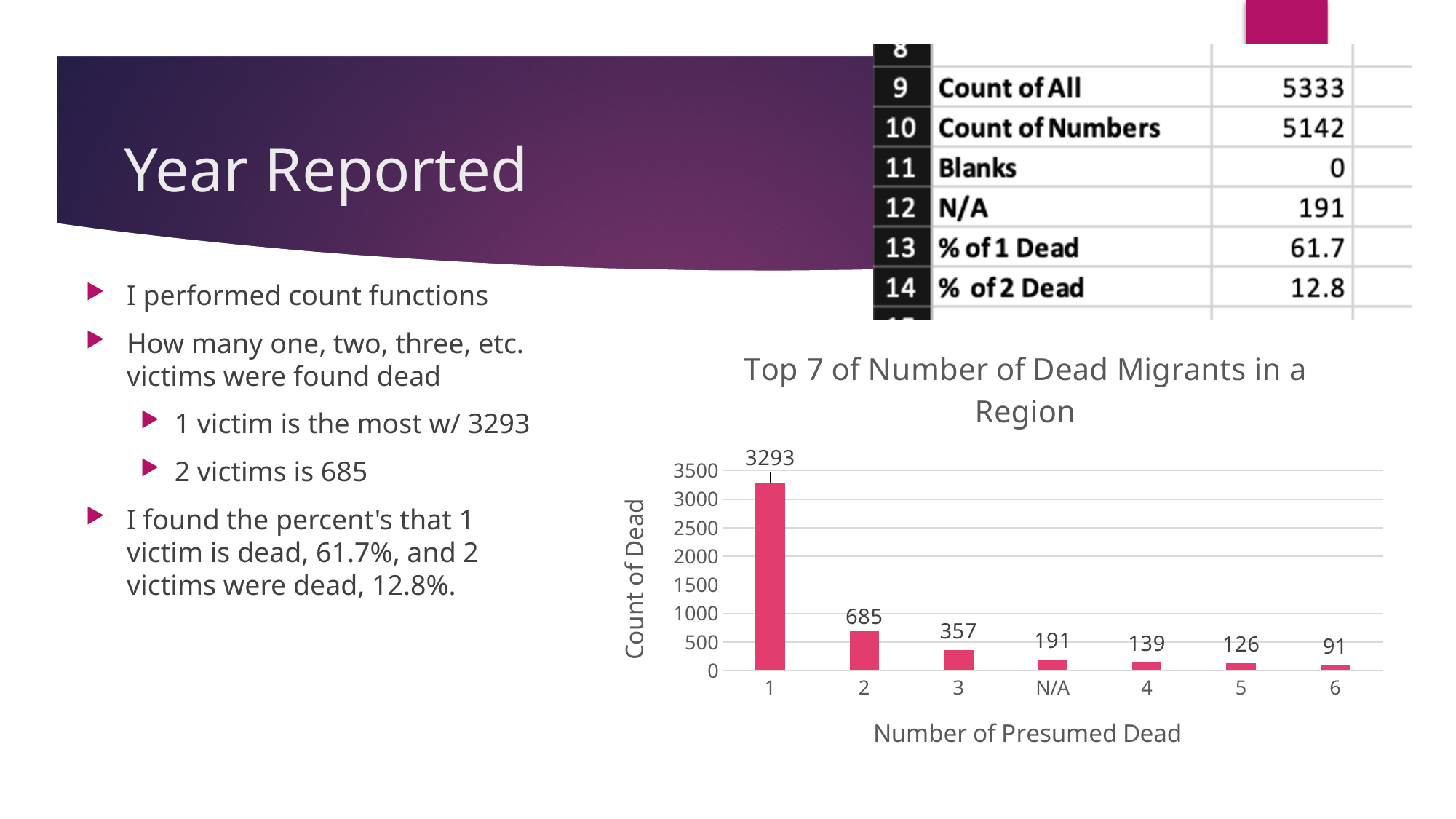
Which is larger, the count for 4 presumed dead or for 5 presumed dead? 4 What is the count of dead for 6 presumed dead? 91 Which category has the lowest count of dead? 6 What is the difference between the counts for 3 presumed dead and N/A? 166 How many categories are shown on the x axis of the chart? 7 What is the count of dead for the N/A category? 191 What is the difference between the counts for 1 and 2 presumed dead? 2608 Which category has the highest count of dead? 1 What kind of chart is shown on the slide? bar chart What is the count of dead for 1 presumed dead? 3293 What is the title of the chart? Top 7 of Number of Dead Migrants in a Region What is the label of the y axis of the chart? Count of Dead